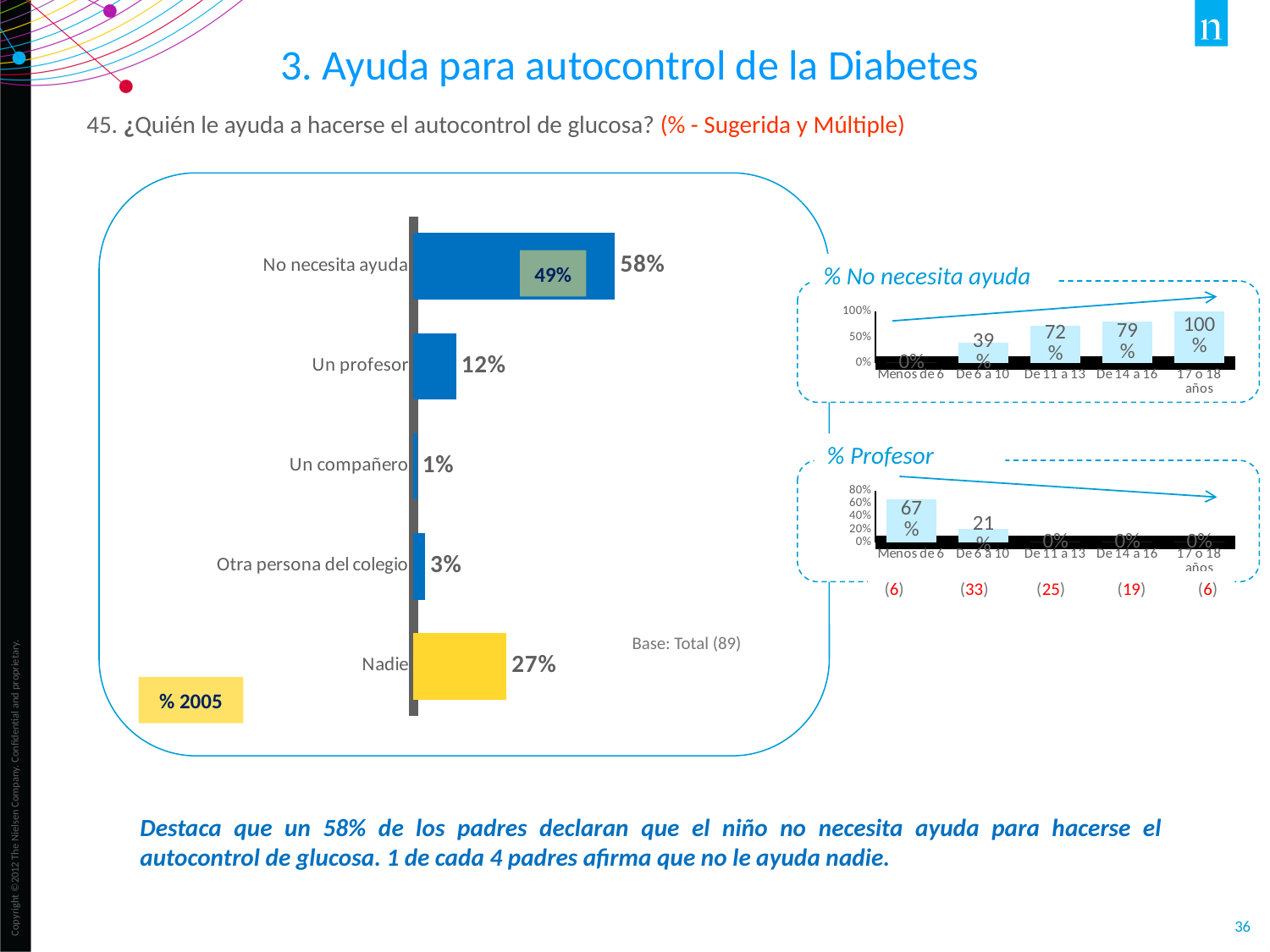
In the main bar chart on the left, what percentage is shown for 'No necesita ayuda'? 58% In the main bar chart on the left, which category has the lowest value? Un compañero In the '% Profesor' chart, what is the value for 'Menos de 6'? 67% In the main bar chart on the left, which category has the highest value? No necesita ayuda In the '% No necesita ayuda' chart, what is the value for 'De 14 a 16'? 79% In the main bar chart on the left, what percentage is shown for 'Nadie'? 27% In the main bar chart on the left, what was the 2005 value shown for 'No necesita ayuda'? 49% In the main bar chart on the left, how many categories are shown? 5 What kind of chart is the main chart on the left? bar chart In the main bar chart on the left, what is the difference between 'Nadie' and 'Un profesor'? 15% In the '% No necesita ayuda' chart, do the values rise or fall from the youngest to the oldest age group? rise In the '% Profesor' chart, which age group has the highest value? Menos de 6